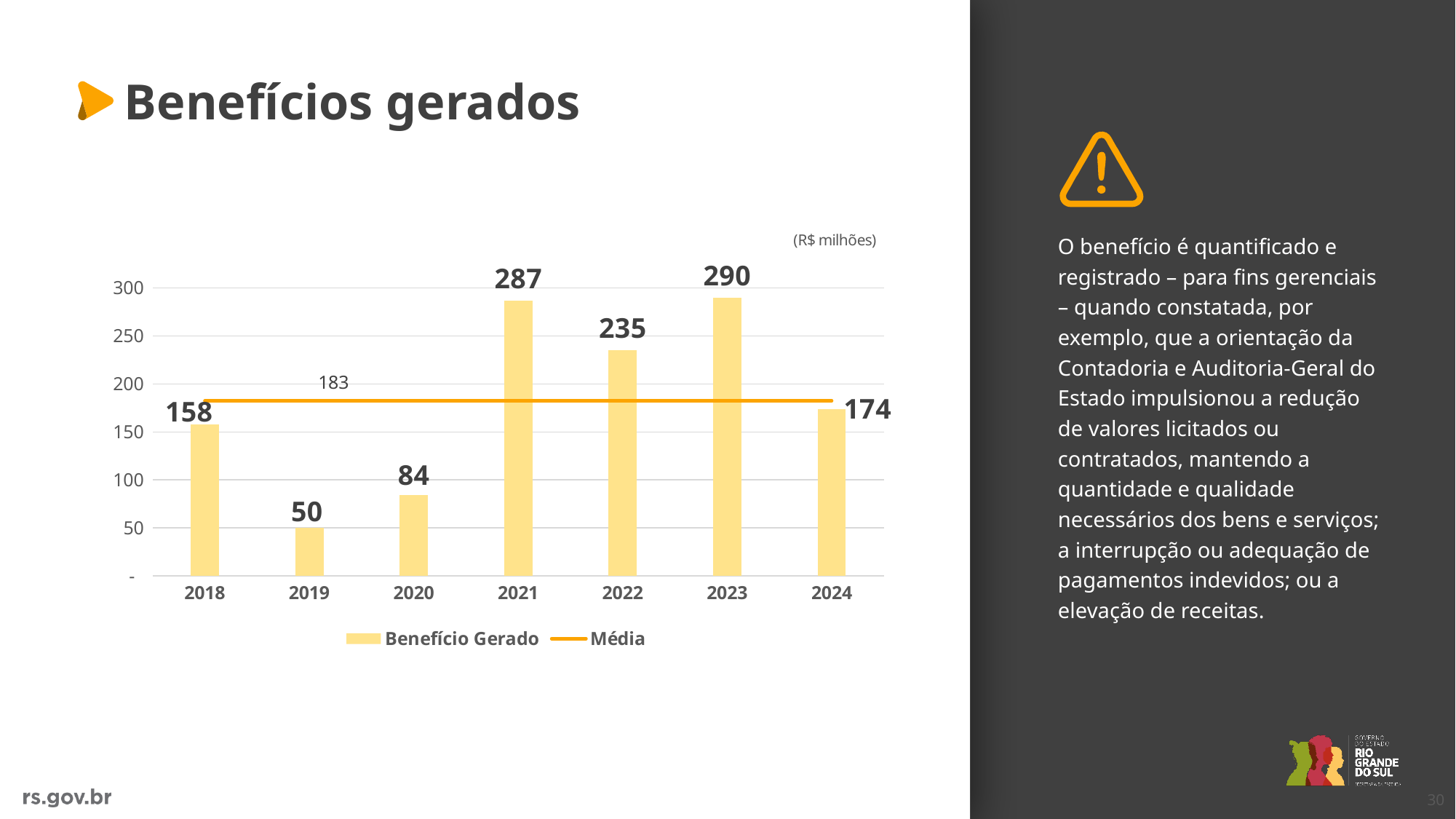
How many series does the legend list? 2 What is the value of Benefício Gerado for 2021? 287 What is the value of Benefício Gerado for 2019? 50 Which is larger, the Benefício Gerado for 2018 or for 2024? 2024 Which year has the highest Benefício Gerado? 2023 How many years are shown on the x axis? 7 What kind of chart is used to show Benefício Gerado? bar chart Is the Benefício Gerado for 2020 greater or less than 100? less What is the difference between the Benefício Gerado values for 2023 and 2022? 55 What unit is indicated above the chart? R$ milhões Which year has the lowest Benefício Gerado? 2019 What value is shown for the Média line? 183